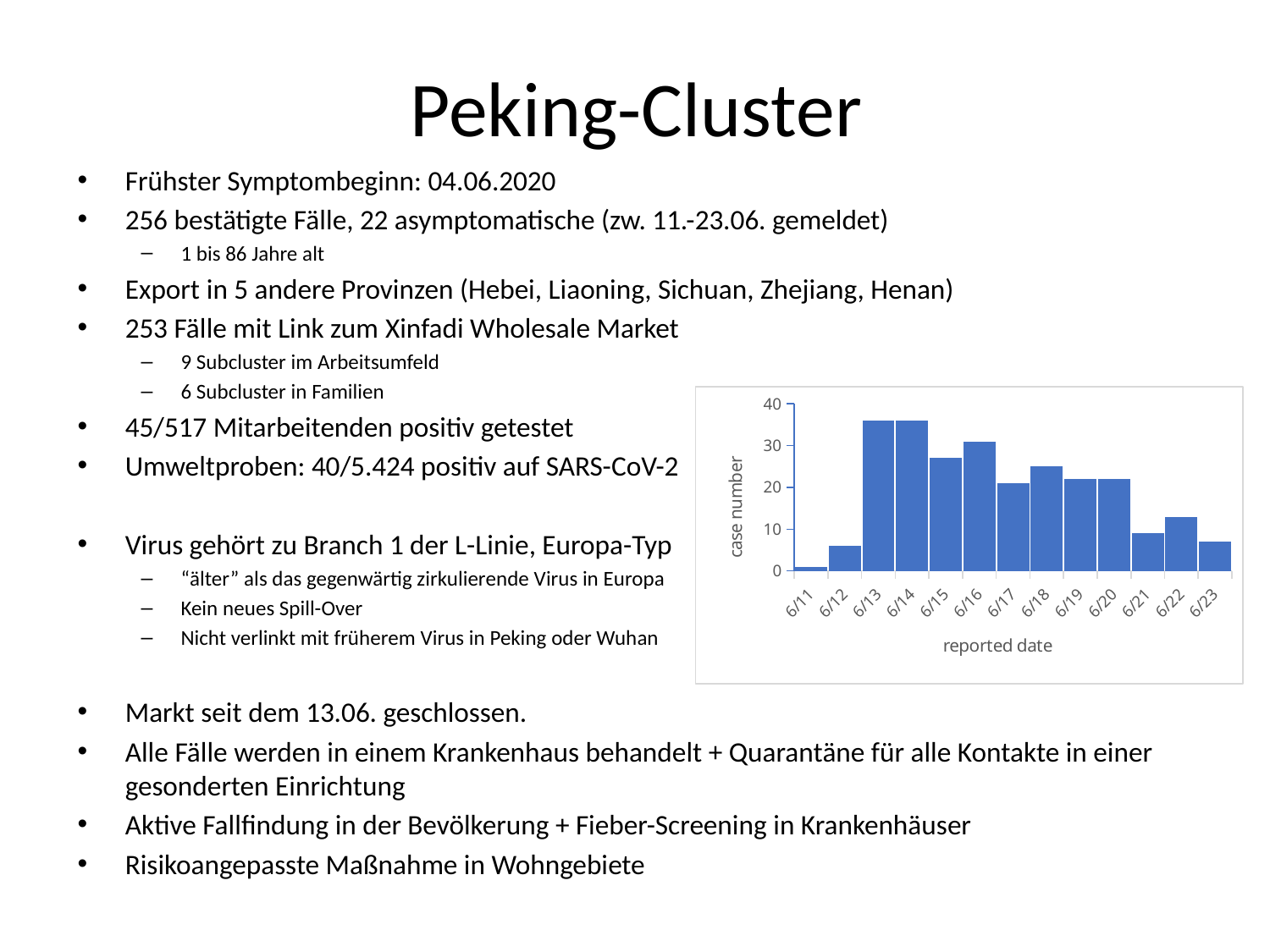
Which reported date has the lowest case number in the chart? 6/11 Which reported date has the larger case number, 6/16 or 6/15? 6/16 What kind of chart is shown on the slide? bar chart Which reported date has the larger case number, 6/18 or 6/17? 6/18 Is the case number for 6/15 greater or less than 20? greater Is the case number for 6/22 greater or less than 10? greater How many reported dates are shown on the x axis of the chart? 13 Do the case numbers generally rise or fall from 6/16 to 6/23? fall Is the case number for 6/13 greater or less than 30? greater What is the label of the x axis of the chart? reported date